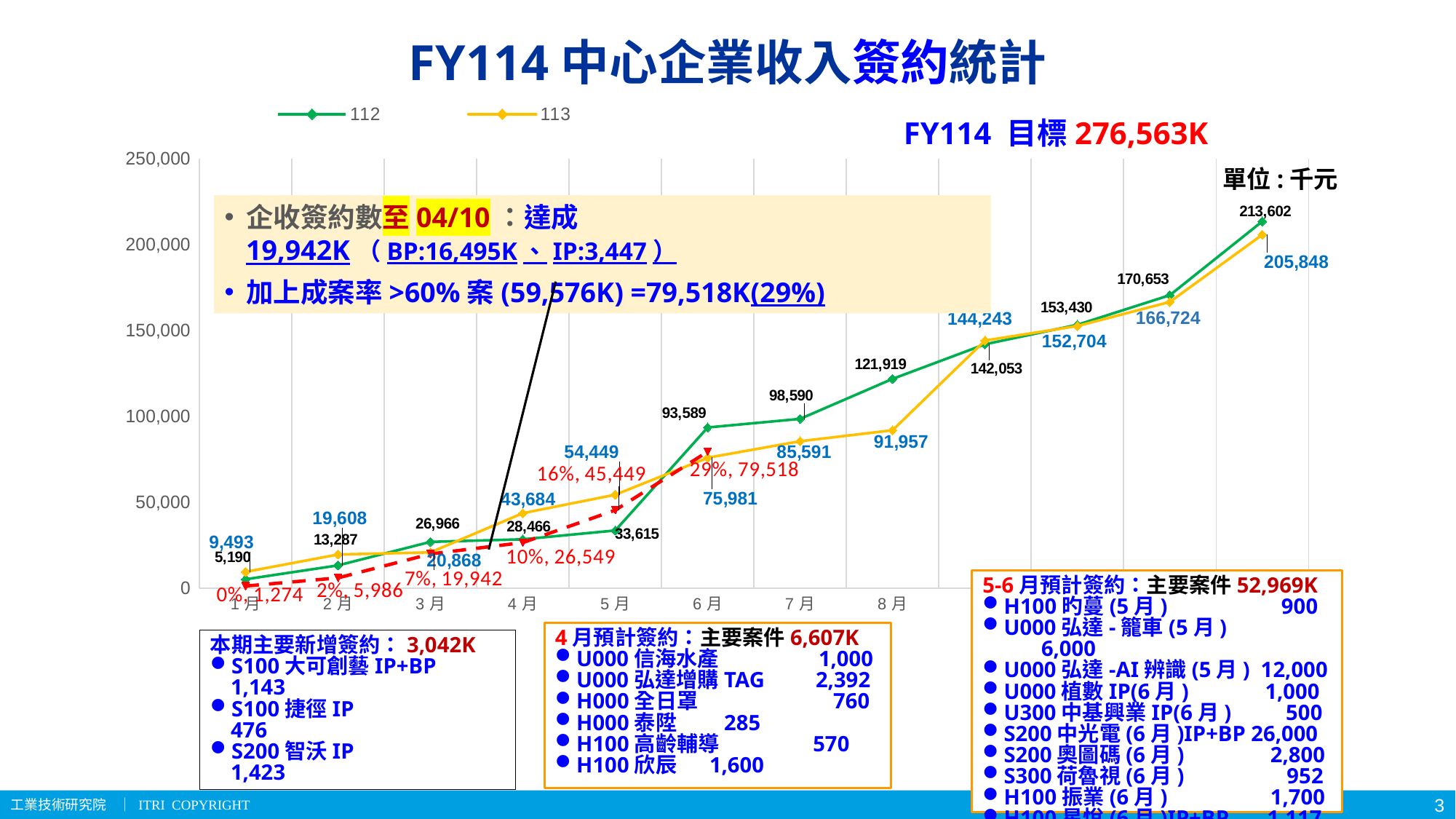
What FY114 target value is stated on the slide? 276,563K What is the difference between series 113 and series 112 at 2月? 6,321 How many series does the chart legend list? 2 At 5月, which series has the higher value, 112 or 113? 113 What is the highest value plotted for series 112? 213,602 What is the value of series 113 at 4月? 43,684 What is the value of series 112 at 6月? 93,589 What is the difference between series 112 and series 113 at 8月? 29,962 What is the value of series 112 at 1月? 5,190 What is the value of series 113 at 8月? 91,957 Do the values of series 112 rise or fall along the x axis? rise What kind of chart is shown on the slide? line chart